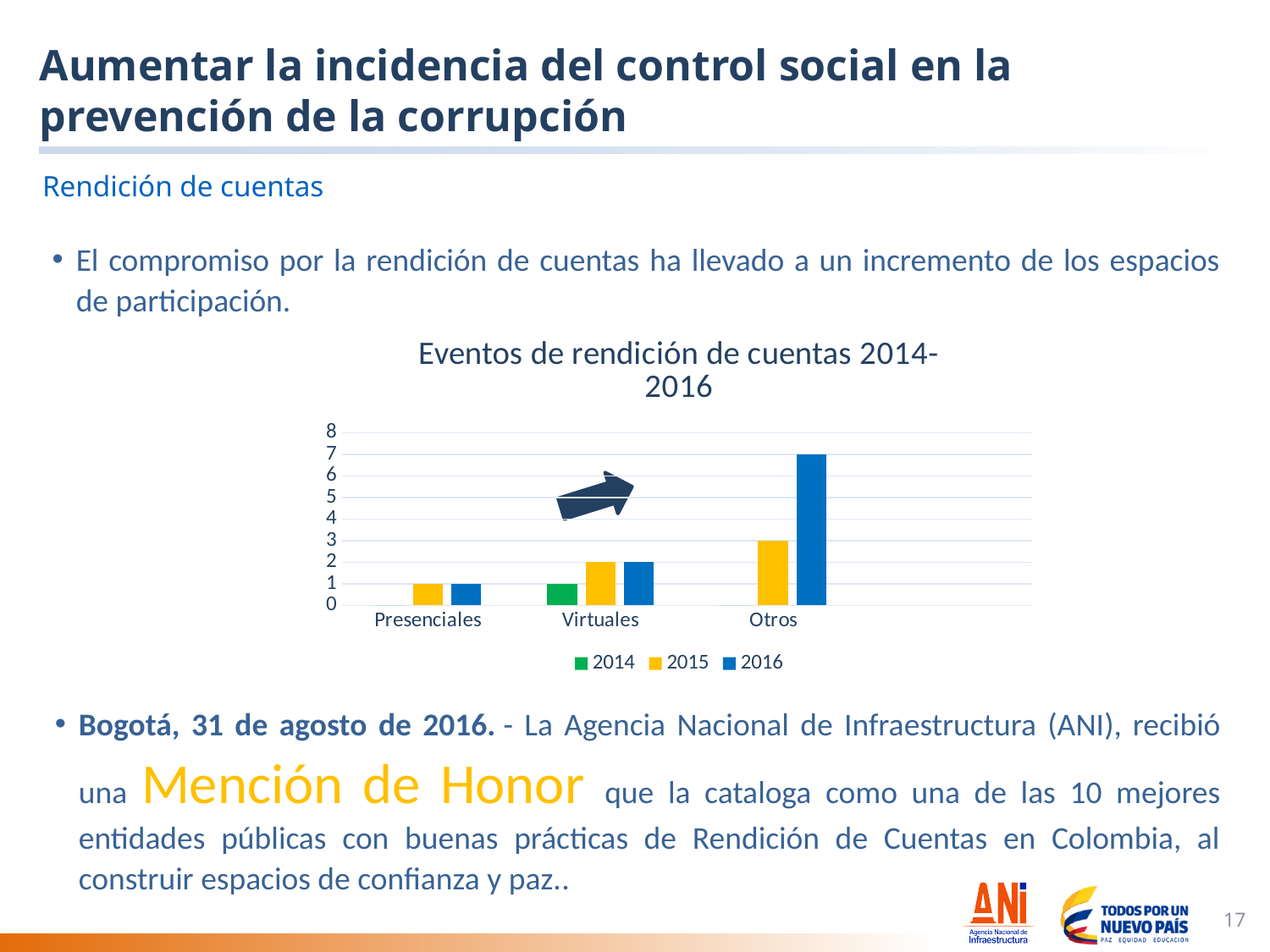
How many categories are shown on the x axis of the chart? 3 Which colour represents the 2014 series in the chart legend? green What is the value for 2016 in the Otros category? 7 What is the value for 2015 in the Virtuales category? 2 Which is larger in the Virtuales category, the 2014 value or the 2015 value? 2015 What kind of chart is shown on the slide? bar chart How many series does the chart legend list? 3 Which category has the tallest bar in the chart? Otros What is the difference between the 2016 and 2015 values in the Otros category? 4 Is the value for 2016 in the Otros category greater or less than 5? greater What is the value for 2015 in the Otros category? 3 What is the title of the chart? Eventos de rendición de cuentas 2014-2016